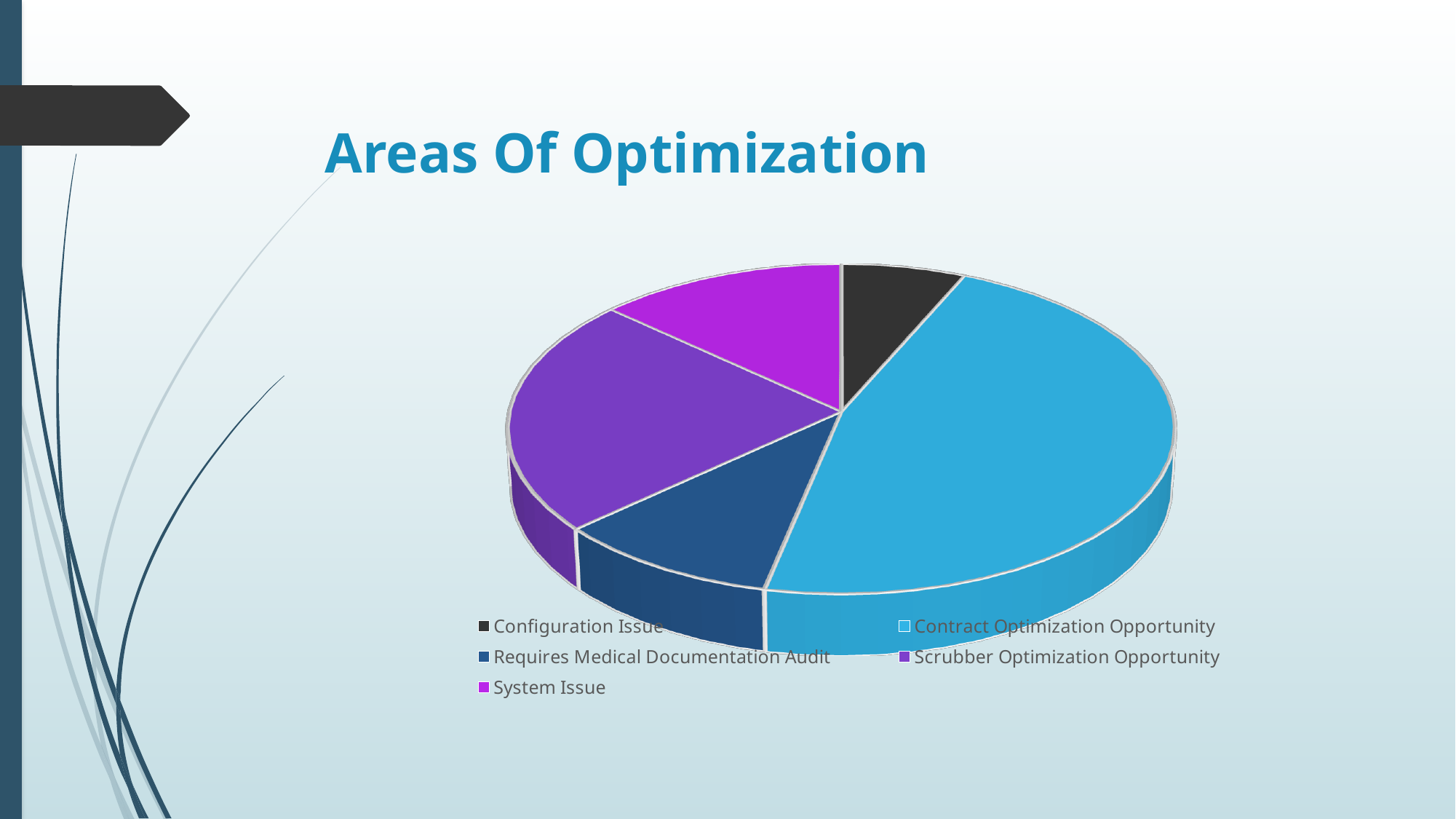
Which slice is larger: Configuration Issue or System Issue? System Issue Which category is shown in black in the pie chart? Configuration Issue What is the title of the slide containing the pie chart? Areas Of Optimization What kind of chart is shown on the slide? Pie chart How many categories does the pie chart have? 5 Which slice is larger: Configuration Issue or Scrubber Optimization Opportunity? Scrubber Optimization Opportunity Which category has the largest slice of the pie? Contract Optimization Opportunity Which slice is larger: Scrubber Optimization Opportunity or Requires Medical Documentation Audit? Scrubber Optimization Opportunity Which category has the smallest slice of the pie? Configuration Issue